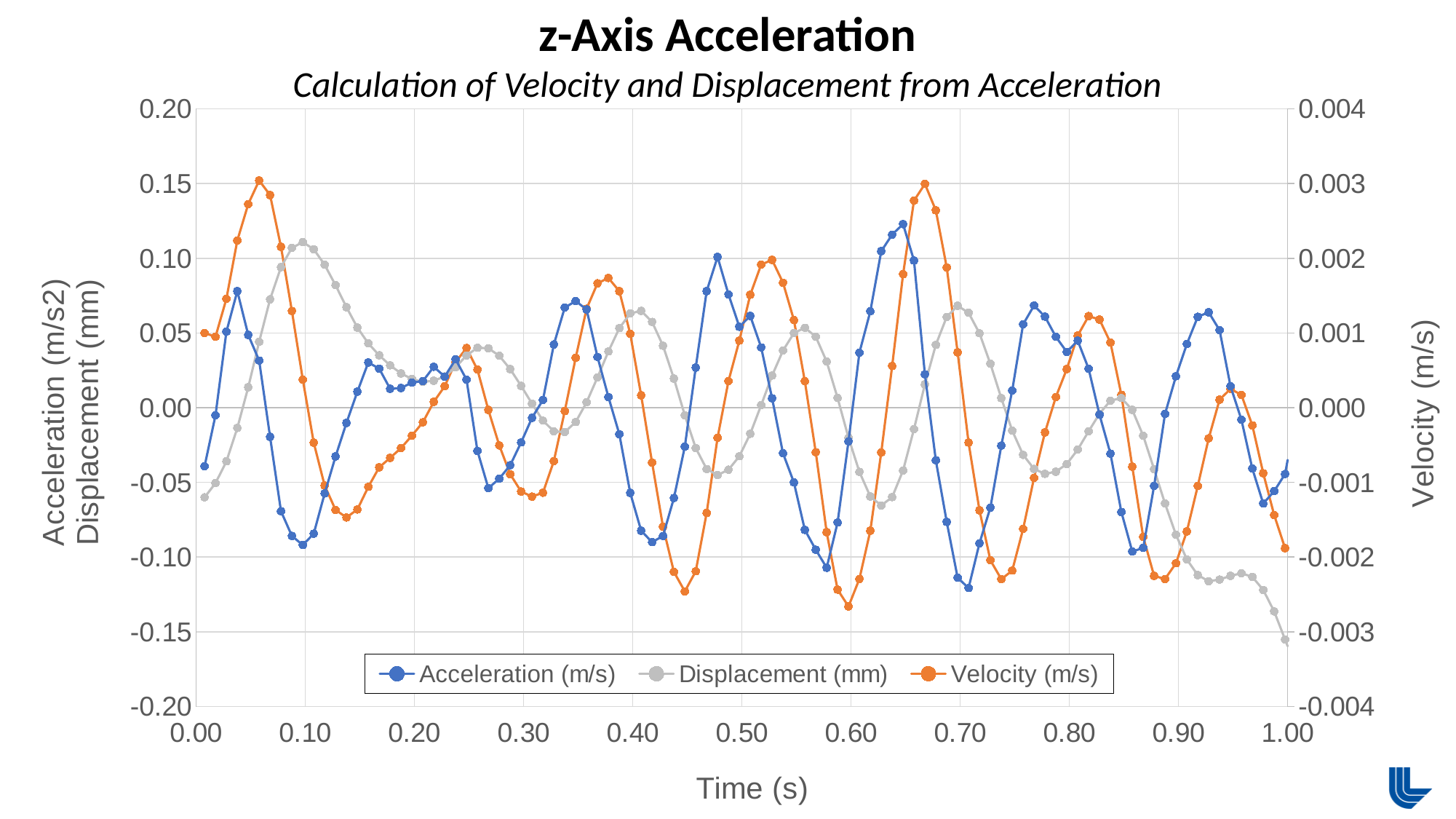
Is the Velocity (m/s) value at 0.06 s greater or less than 0.002? greater How many series does the legend list? 3 What kind of chart is shown on the slide? line chart What is the title of the chart? z-Axis Acceleration Does the Displacement (mm) series rise or fall between 0.95 s and 1.00 s? fall Does the Acceleration (m/s) series rise or fall between 0.60 s and 0.65 s? rise Which series is plotted against the right-hand axis? Velocity (m/s) Is the Acceleration (m/s) value at 0.10 s greater or less than -0.05? less Is the Acceleration (m/s) value at 0.65 s greater or less than 0.10? greater